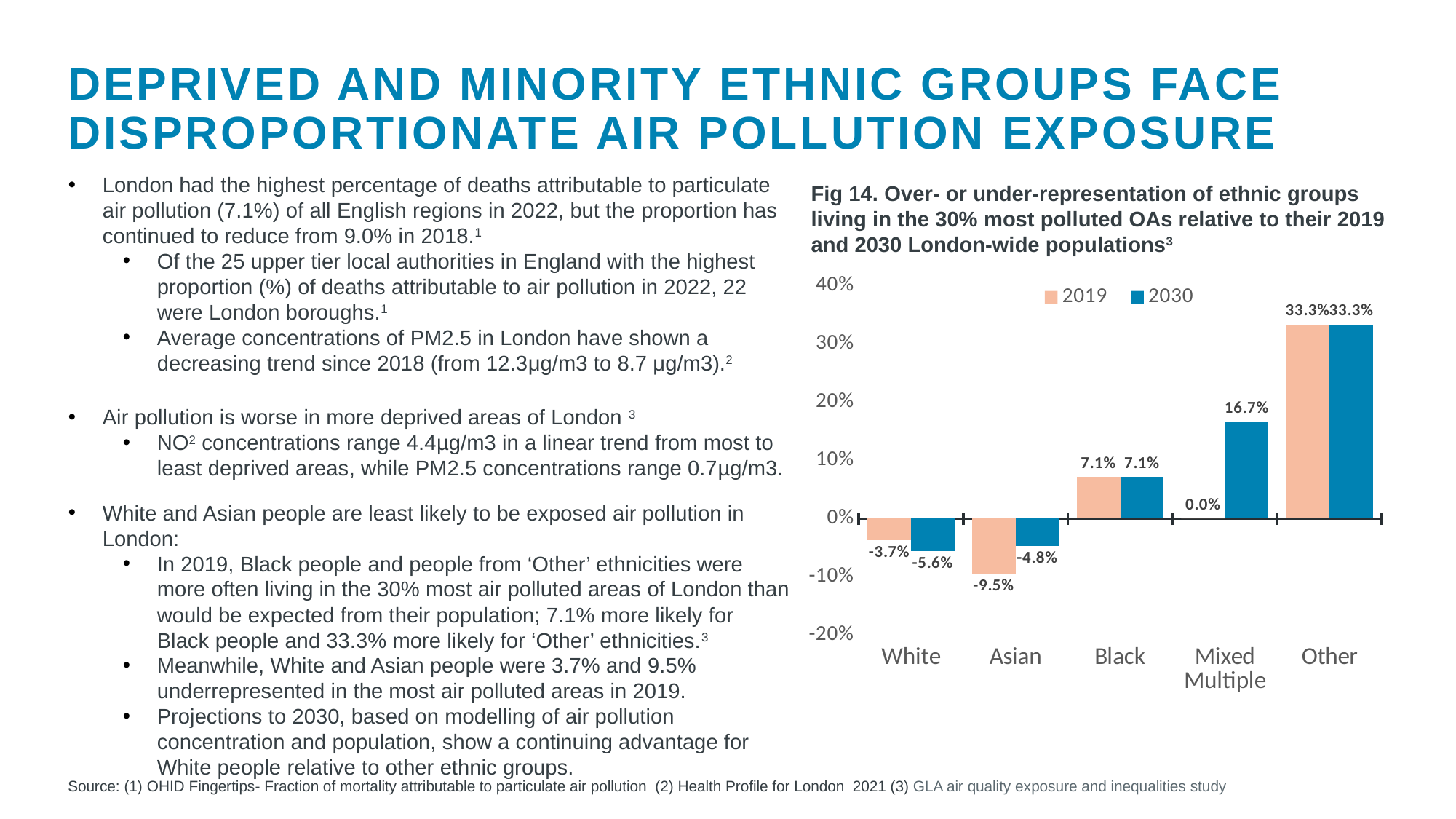
How many series does the legend of Fig 14 list? 2 What is the difference between the 2030 and 2019 values for Mixed Multiple in Fig 14? 16.7% What type of chart is Fig 14? Bar chart What is the 2030 value for White in Fig 14? -5.6% What is the 2030 value for Mixed Multiple in Fig 14? 16.7% Which is larger for Asian in Fig 14: the 2019 value or the 2030 value? 2030 Which ethnic group has the lowest 2019 value in Fig 14? Asian Which series in Fig 14 is shown in dark blue? 2030 What is the 2019 value for Asian in Fig 14? -9.5% Which ethnic group has the highest 2030 value in Fig 14? Other How many ethnic groups are shown on the x axis of Fig 14? 5 What is the 2019 value for Black in Fig 14? 7.1%